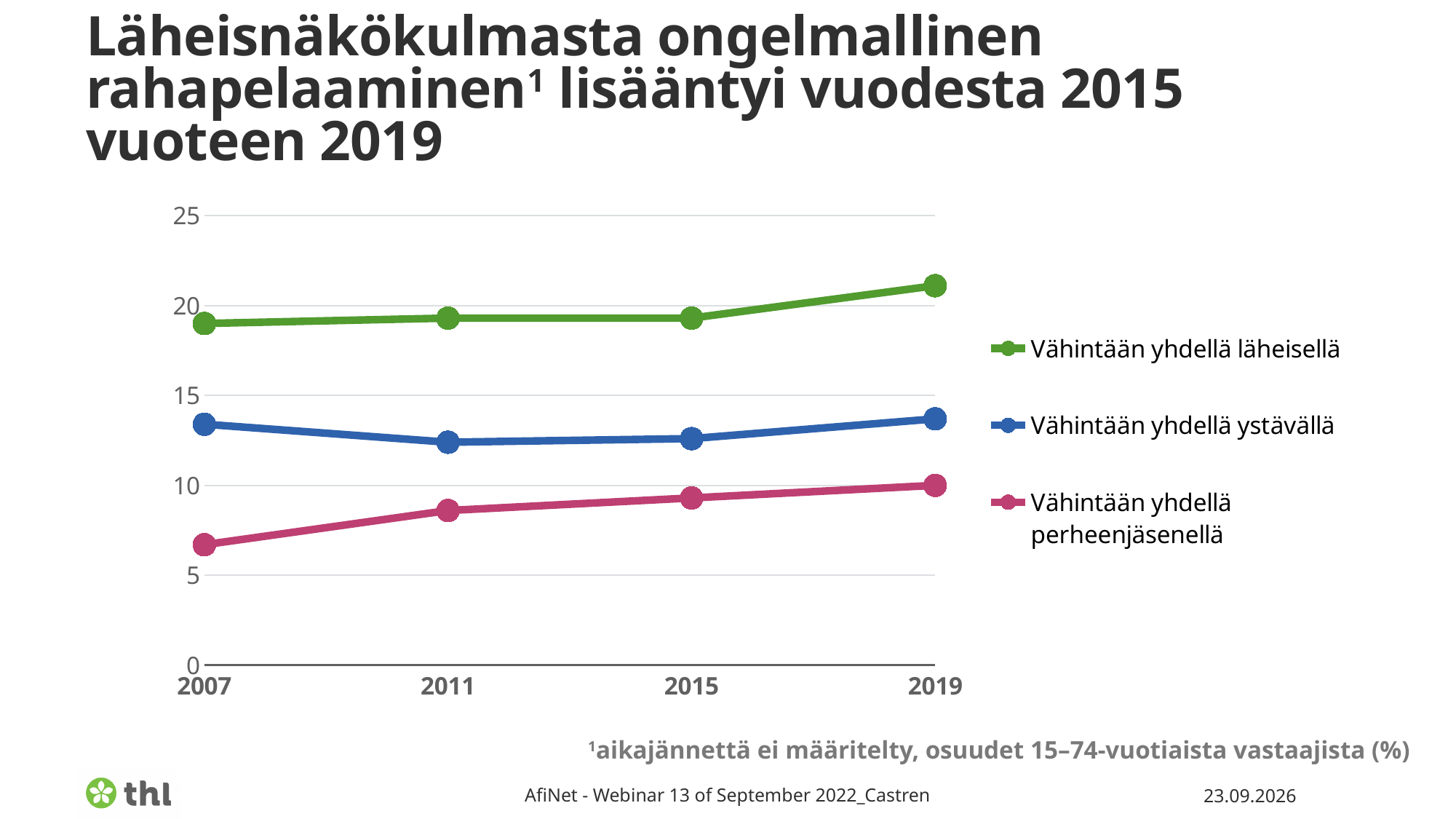
Is the value for Vähintään yhdellä läheisellä in 2019 greater or less than 20? greater Which is larger in 2011: the value for Vähintään yhdellä ystävällä or for Vähintään yhdellä perheenjäsenellä? Vähintään yhdellä ystävällä Which series has the lowest values across all years? Vähintään yhdellä perheenjäsenellä How many years are plotted along the x axis? 4 How many series does the legend list? 3 Is the value for Vähintään yhdellä ystävällä in 2007 greater or less than 15? less Is the value for Vähintään yhdellä läheisellä in 2007 greater or less than 20? less What colour is the line for Vähintään yhdellä ystävällä? blue What kind of chart is shown on the slide? line chart Which series has the highest values across all years? Vähintään yhdellä läheisellä Does the value for Vähintään yhdellä perheenjäsenellä rise or fall from 2007 to 2019? rise